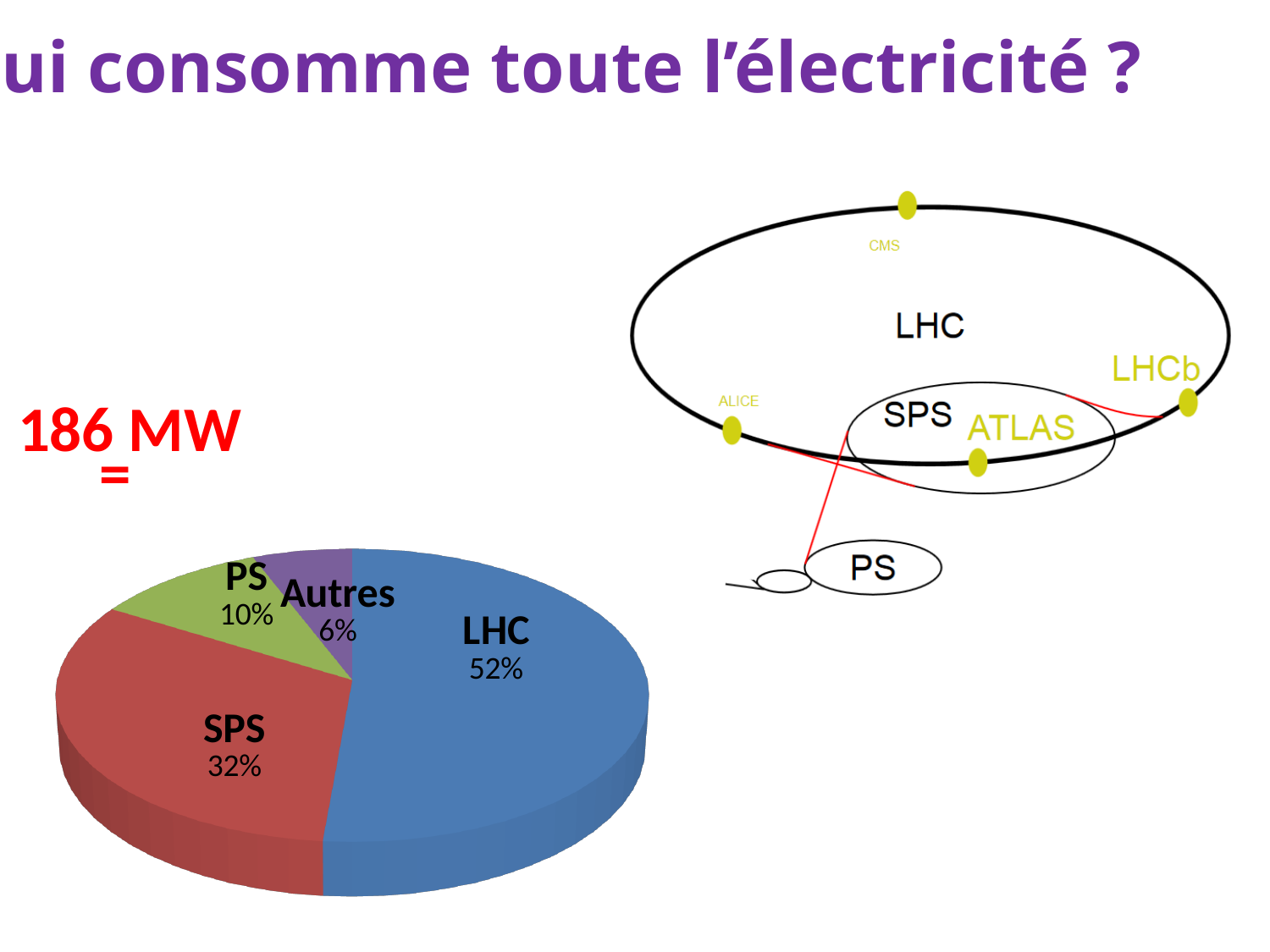
What kind of chart is shown on the slide? pie chart Which slice of the pie is the largest? LHC What is the difference in percentage points between the LHC and SPS slices? 20 What share of the pie does PS account for? 10% Which slice of the pie is the smallest? Autres Which slice is larger, PS or Autres? PS What share of the pie does LHC account for? 52% What share of the pie does SPS account for? 32% How many slices does the pie chart have? 4 What total power figure is shown next to the pie chart? 186 MW What colour is the LHC slice of the pie? blue